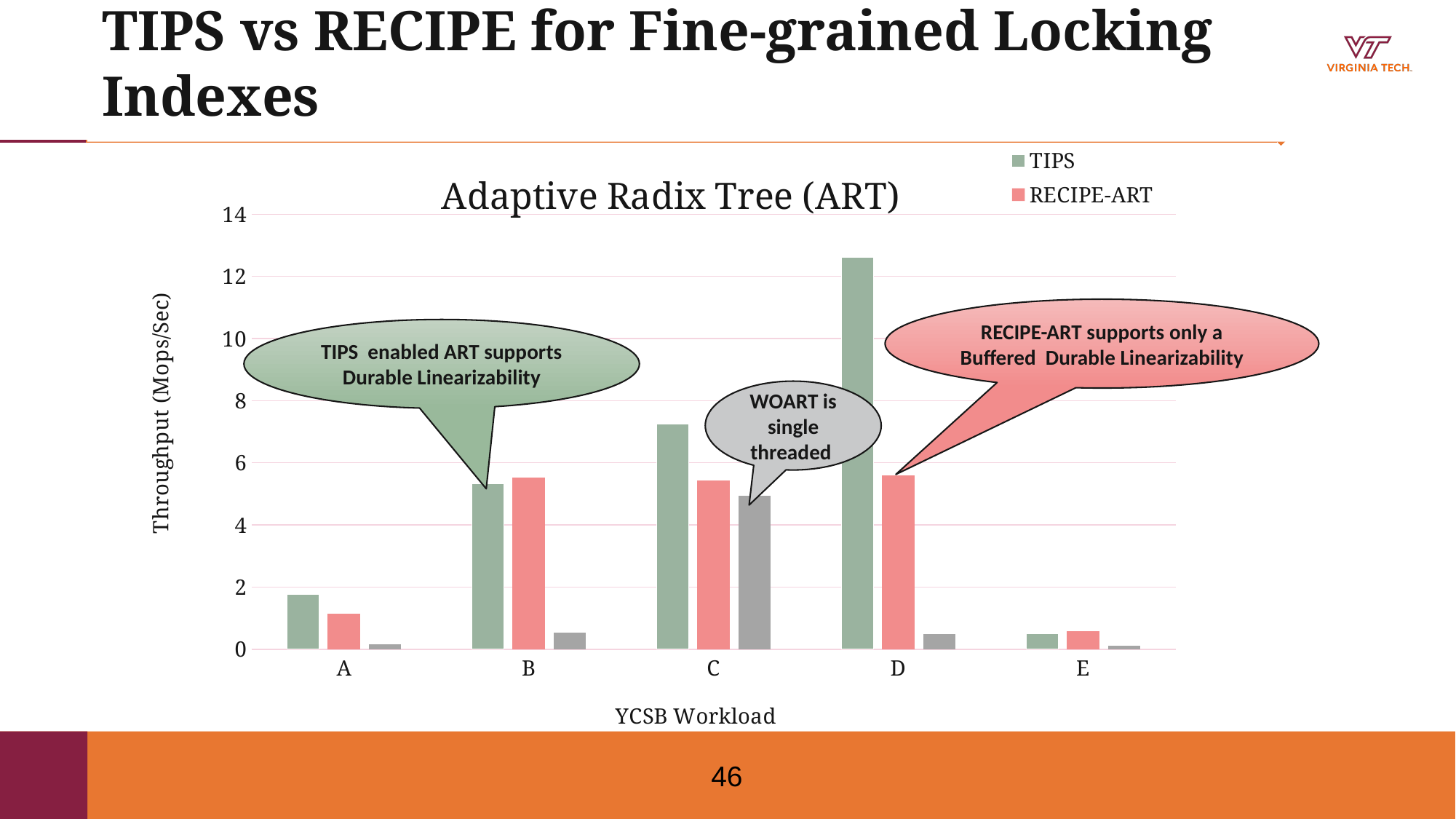
Is the TIPS value for workload D greater or less than 10? greater What is the label of the y-axis? Throughput (Mops/Sec) Is the TIPS value for workload C greater or less than 8? less For which workload is the TIPS throughput highest? D Is the RECIPE-ART value for workload A greater or less than 2? less What kind of chart is shown on the slide? bar chart How many YCSB workload categories are shown on the x-axis? 5 For which workload is the TIPS throughput lowest? E What is the title of the chart? Adaptive Radix Tree (ART) How many series does the legend list? 2 For workload C, which is larger: TIPS or RECIPE-ART? TIPS For workload D, which is larger: TIPS or RECIPE-ART? TIPS